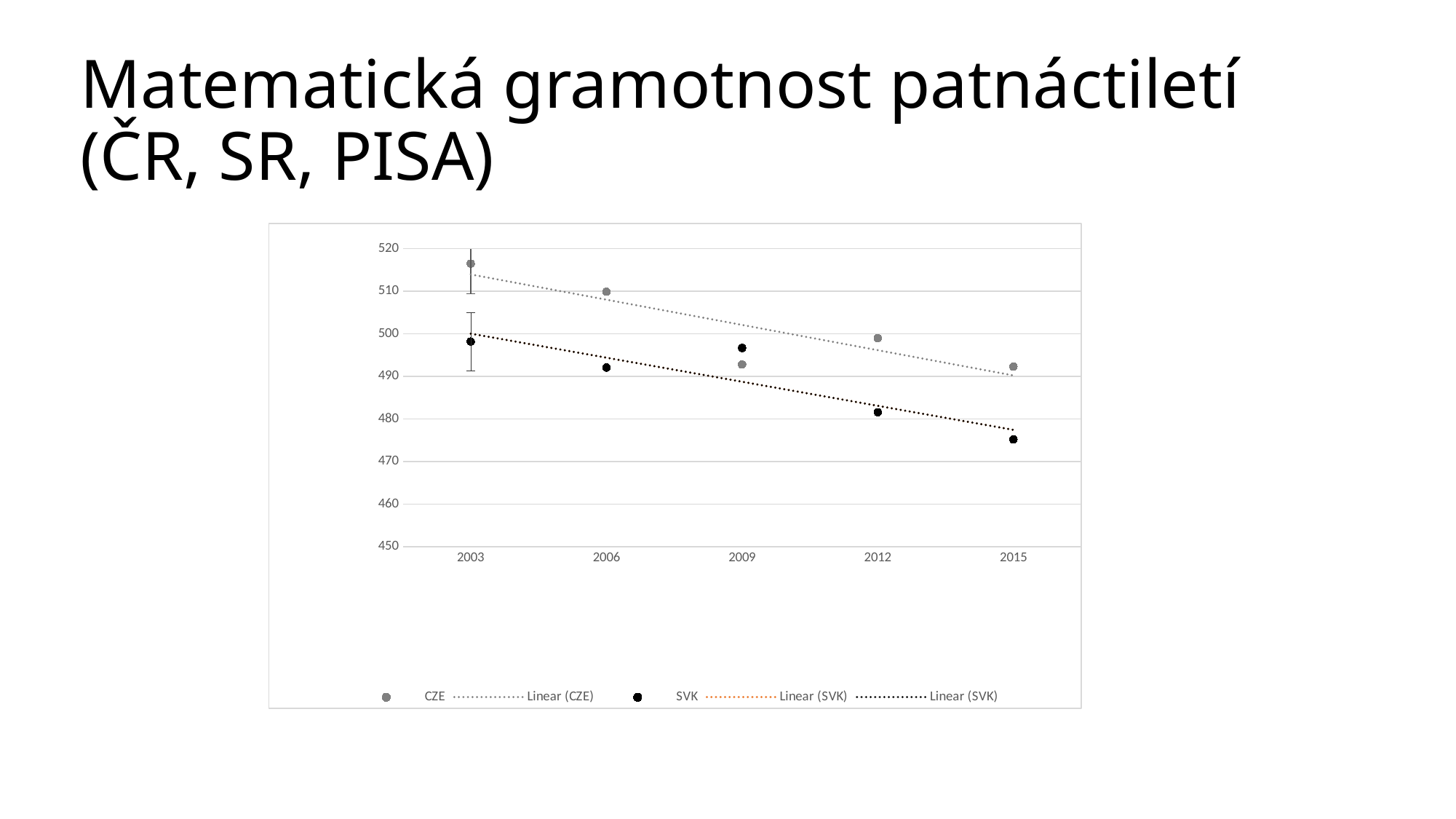
Is the SVK value for 2015 greater or less than 480? less In which year is the SVK value lowest? 2015 Is the CZE value for 2006 greater or less than 500? greater Which series has the larger value in 2003, CZE or SVK? CZE Do the CZE values generally rise or fall from 2003 to 2015? fall Which series has the larger value in 2015, CZE or SVK? CZE How many years are plotted on the x axis? 5 Do the SVK values generally rise or fall from 2003 to 2015? fall What kind of chart is shown on the slide? scatter chart What is the title of the slide containing the chart? Matematická gramotnost patnáctiletí (ČR, SR, PISA) Is the CZE value for 2003 greater or less than 510? greater In which year is the CZE value highest? 2003